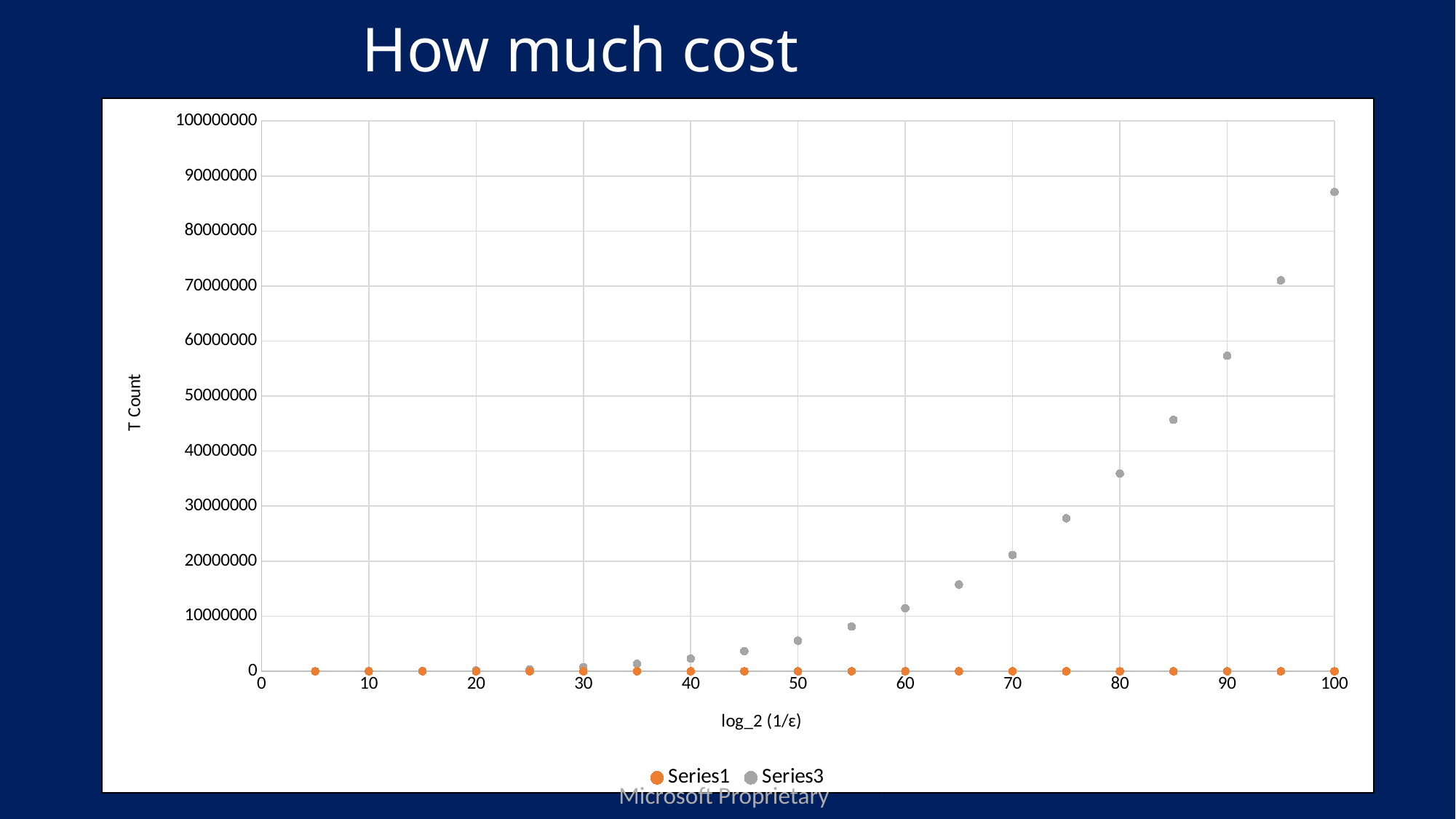
What kind of chart is shown on the slide? scatter chart Is the Series3 value at log_2 (1/ε) = 100 greater or less than 80000000? greater At log_2 (1/ε) = 100, which series has the larger value, Series1 or Series3? Series3 What is the title of the y axis? T Count Do the Series3 values rise or fall as log_2 (1/ε) increases? rise At which log_2 (1/ε) value does Series3 reach its highest point? 100 Which series stays near 0 across the whole x axis? Series1 Is the Series3 value at log_2 (1/ε) = 80 greater or less than 40000000? less Is the Series3 value at log_2 (1/ε) = 60 greater or less than 10000000? greater What are the names of the series in the legend? Series1 and Series3 How many series does the legend list? 2